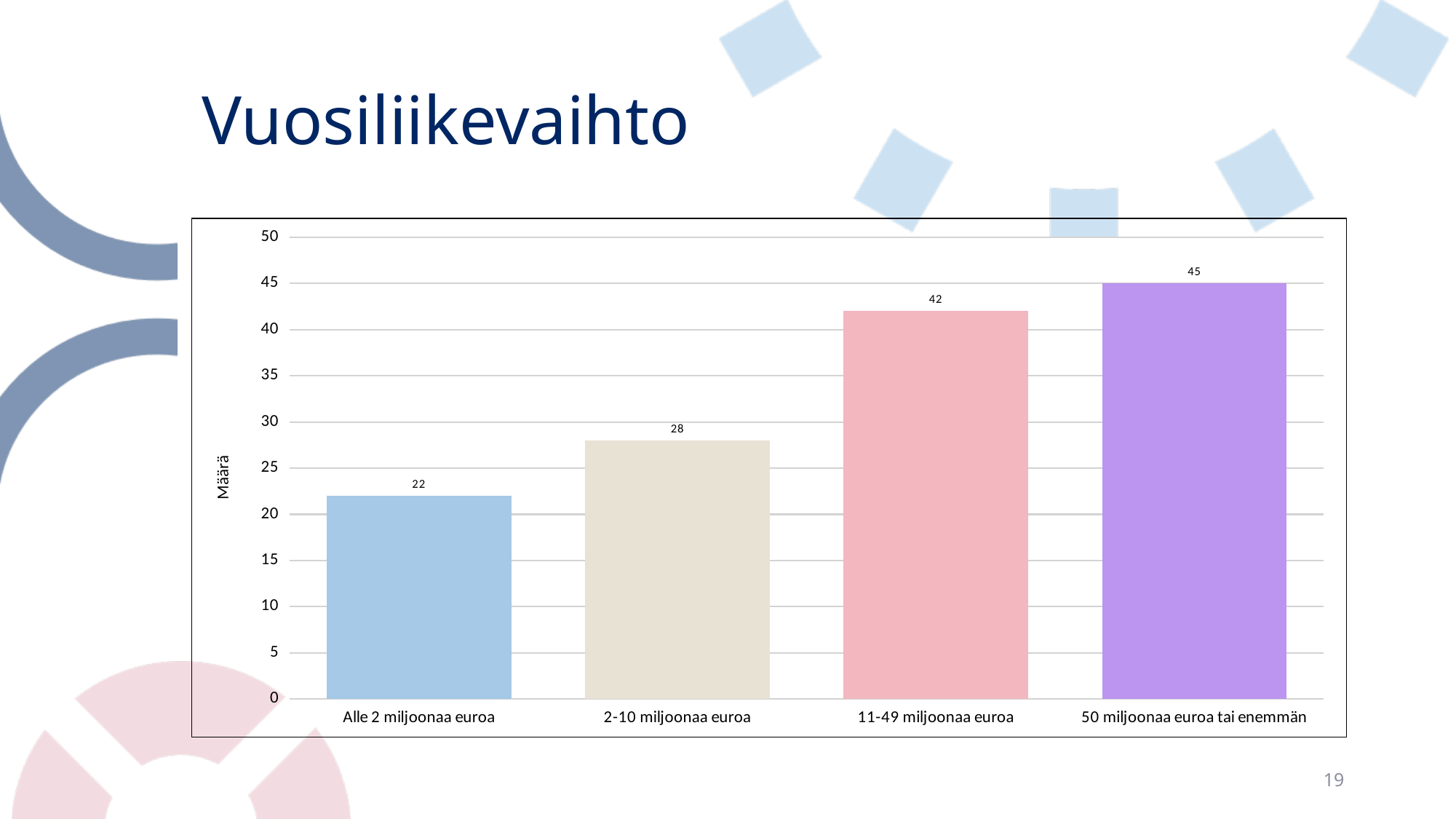
How many categories are shown in the chart? 4 Which is larger, the value for "2-10 miljoonaa euroa" or the value for "11-49 miljoonaa euroa"? 11-49 miljoonaa euroa Do the values rise or fall from left to right along the x axis? rise Which category has the lowest value? Alle 2 miljoonaa euroa What is the value for "11-49 miljoonaa euroa"? 42 What is the value for "50 miljoonaa euroa tai enemmän"? 45 Is the value for "2-10 miljoonaa euroa" greater or less than 30? less What is the difference between the values for "50 miljoonaa euroa tai enemmän" and "Alle 2 miljoonaa euroa"? 23 What is the value for "Alle 2 miljoonaa euroa"? 22 What is the value for "2-10 miljoonaa euroa"? 28 Which category has the highest value? 50 miljoonaa euroa tai enemmän What kind of chart is shown on the slide? bar chart